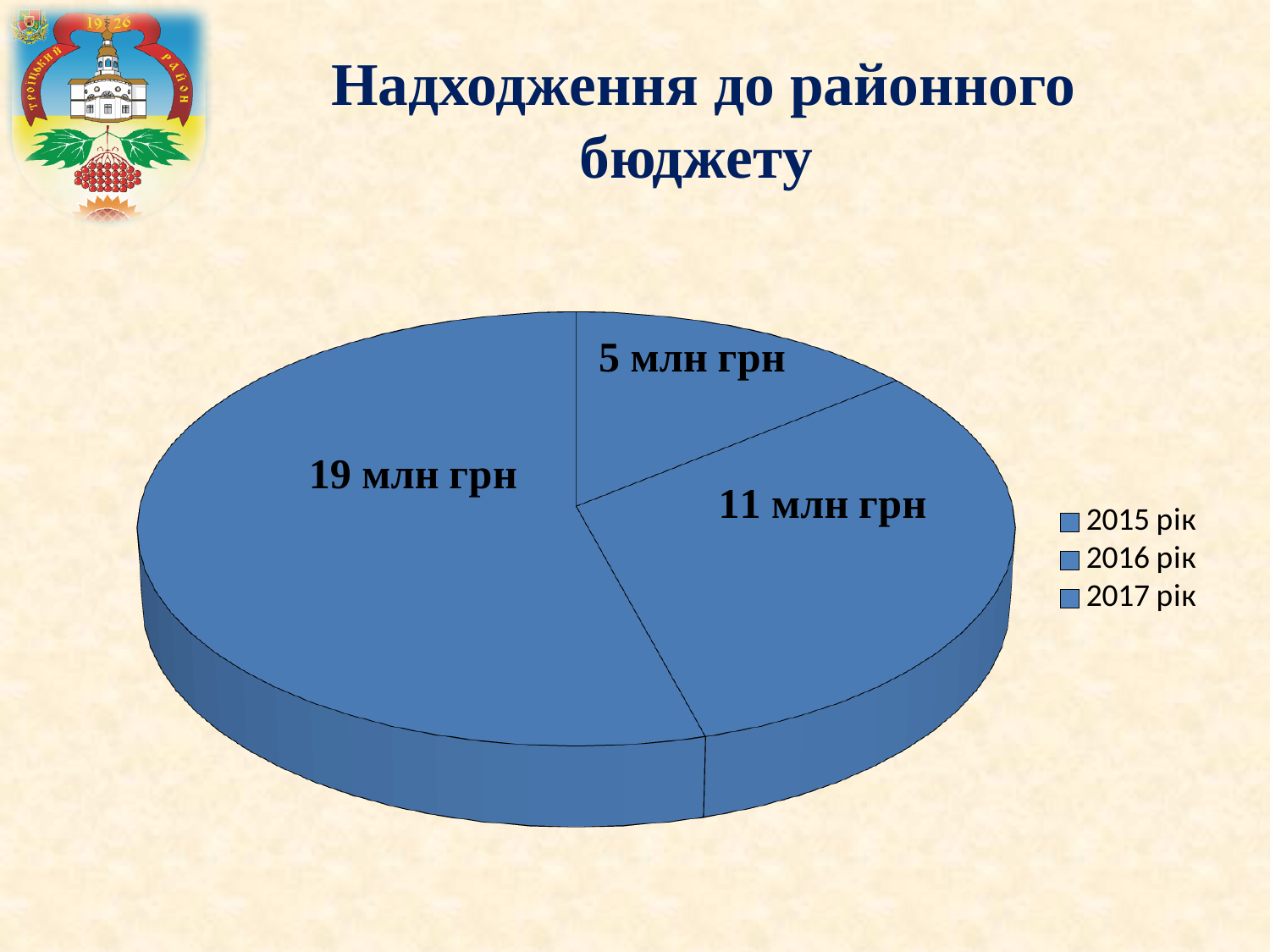
How many slices does the pie chart have? 3 What is the total of all three slice values shown in the pie chart? 35 млн грн What is the value of the smallest slice in the pie chart? 5 млн грн What is the difference between the 11 млн грн slice and the 5 млн грн slice? 6 млн грн What is the difference between the largest slice (19 млн грн) and the 11 млн грн slice? 8 млн грн What is the value of the largest slice in the pie chart? 19 млн грн What type of chart is shown on the slide? pie chart What is the difference between the largest and smallest slices of the pie chart? 14 млн грн What is the title of the chart on the slide? Надходження до районного бюджету Which years are listed in the legend of the pie chart? 2015 рік, 2016 рік, 2017 рік Does the 19 млн грн slice make up more than half of the pie? yes How many entries does the legend of the pie chart list? 3